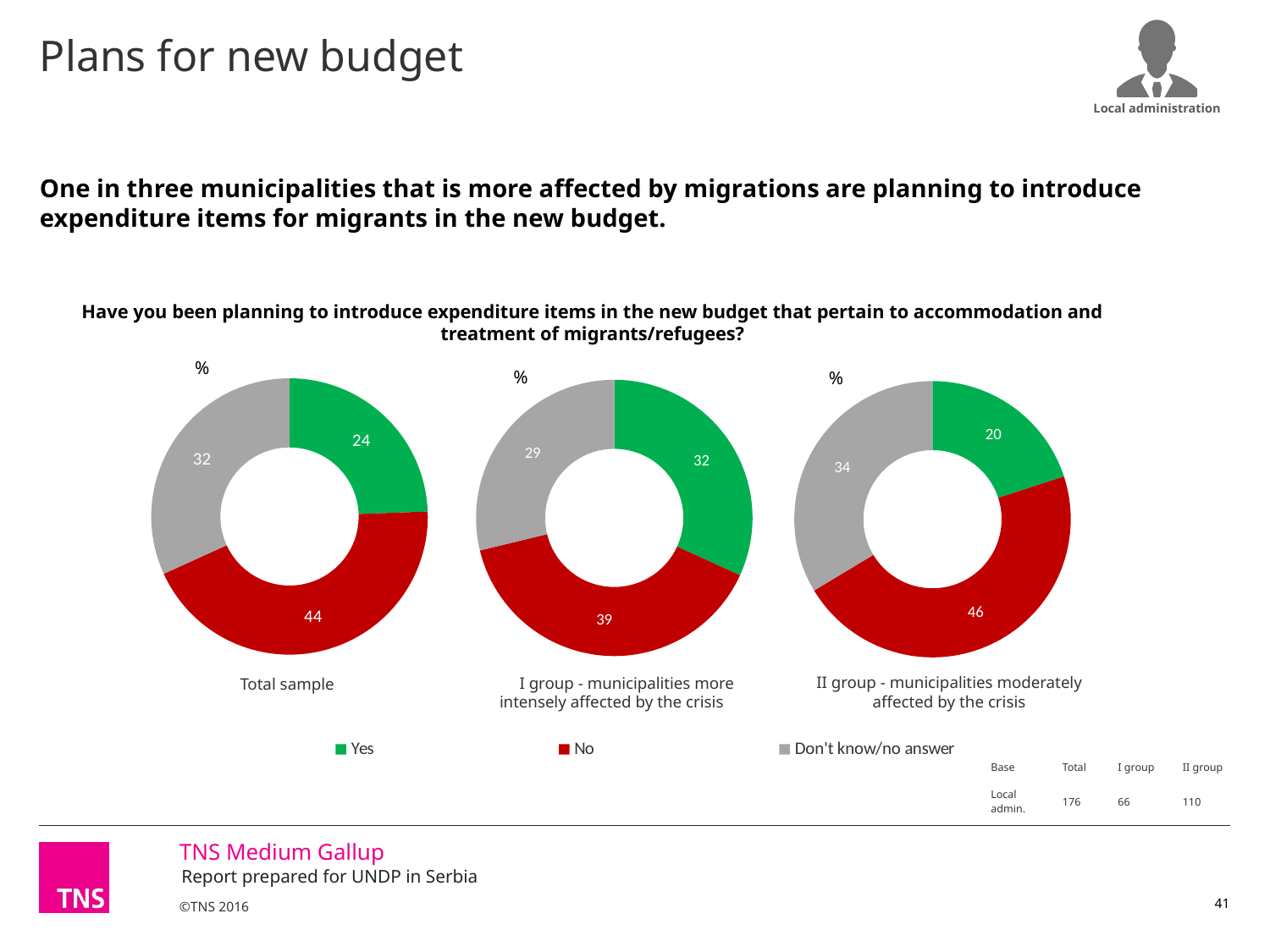
In the Total sample chart, what percentage answered Yes? 24 What type of chart is used on this slide? Doughnut chart In the Total sample chart, what is the combined share of No and Don't know/no answer? 76 In the I group chart, what is the difference between the No and Yes percentages? 7 In the Total sample chart, which response has the largest share? No How many doughnut charts are shown on the slide? 3 Is the Yes share larger in the I group chart or the II group chart? I group In the II group chart (municipalities moderately affected by the crisis), what percentage answered Don't know/no answer? 34 How many response categories does the legend list? 3 Which colour represents the No response in the charts? Red In the I group chart (municipalities more intensely affected by the crisis), what percentage answered No? 39 In the II group chart, which response has the smallest share? Yes